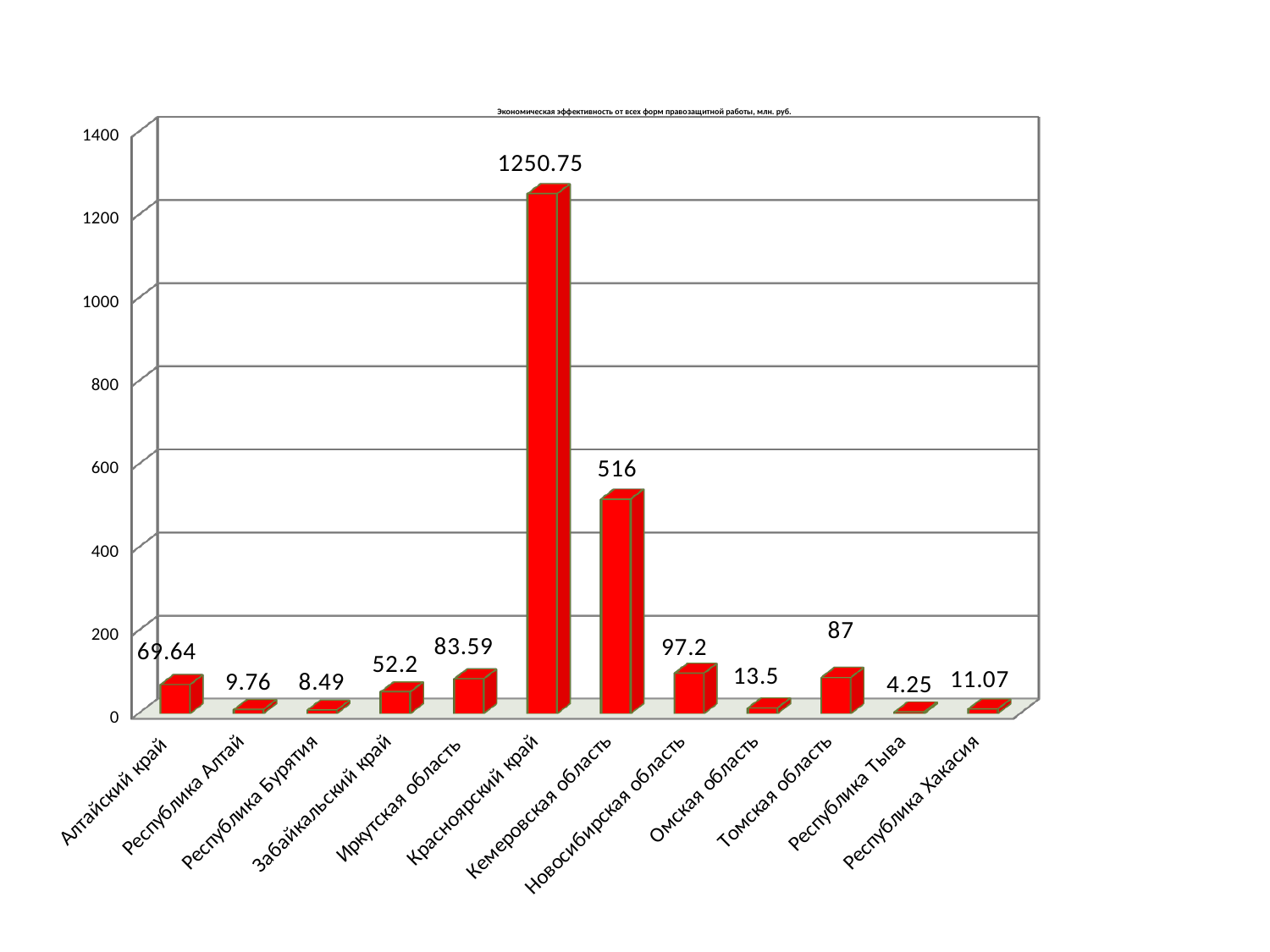
Which is larger, the value for Томская область or the value for Иркутская область? Томская область How many regions are shown on the x axis? 12 What is the value for Республика Тыва? 4.25 What is the difference between the values for Красноярский край and Кемеровская область? 734.75 Is the value for Кемеровская область greater or less than 400? greater What kind of chart is this? bar chart Which region has the lowest value? Республика Тыва What is the difference between the values for Алтайский край and Забайкальский край? 17.44 What is the value for Кемеровская область? 516 Which region has the highest value? Красноярский край What is the value for Новосибирская область? 97.2 What is the value for Красноярский край? 1250.75